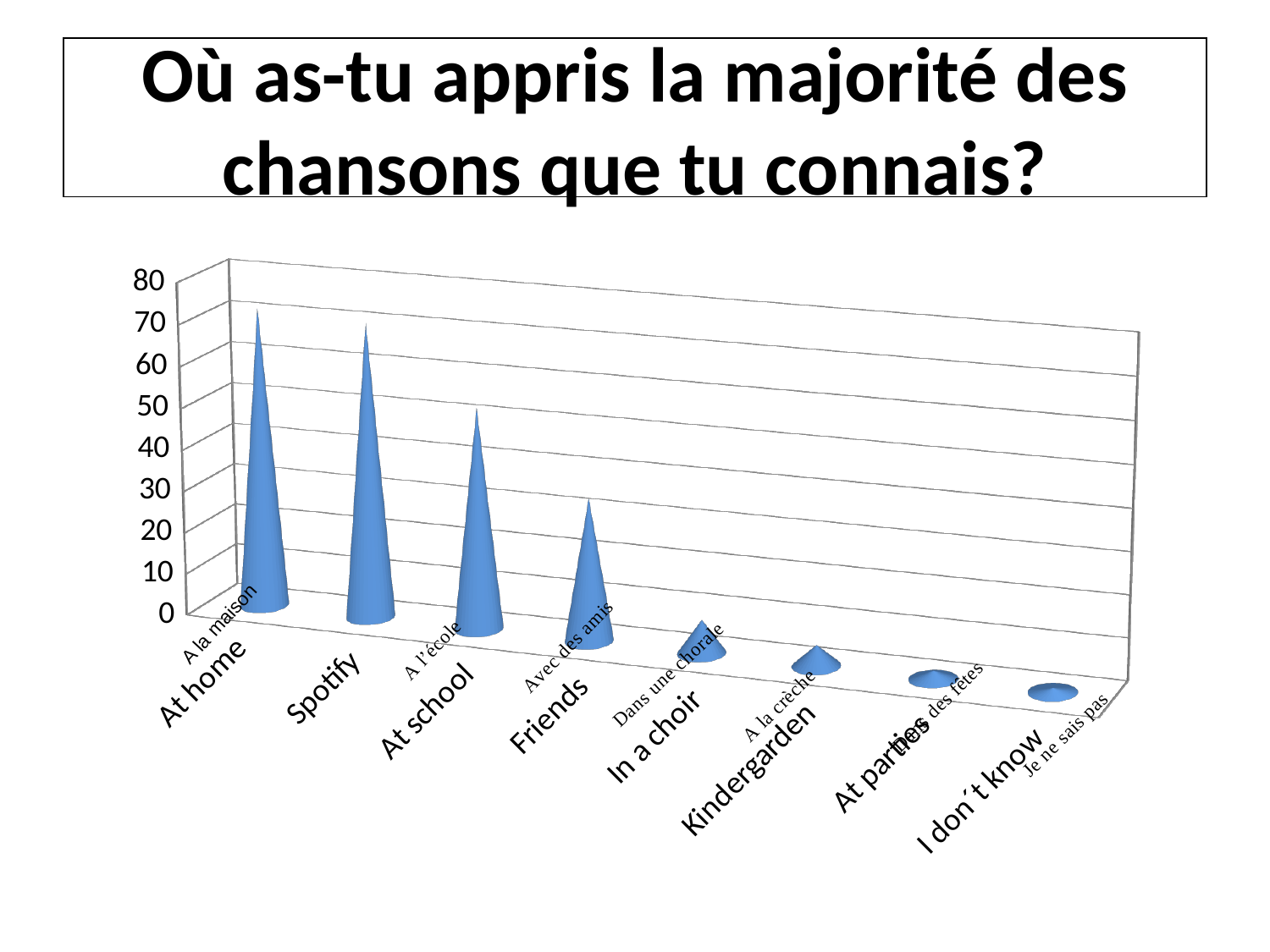
What is the title shown above the chart on the slide? Où as-tu appris la majorité des chansons que tu connais? Is the value for Friends greater or less than 40? less Is the value for Spotify greater or less than 50? greater Is the value for At school greater or less than 30? greater How many categories are shown on the x axis of the chart? 8 Which is larger, the value for At school or the value for Friends? At school What kind of chart is shown on the slide? bar chart Do the values rise or fall moving from left to right along the x axis? fall Which category has the lowest value in the chart? I don't know